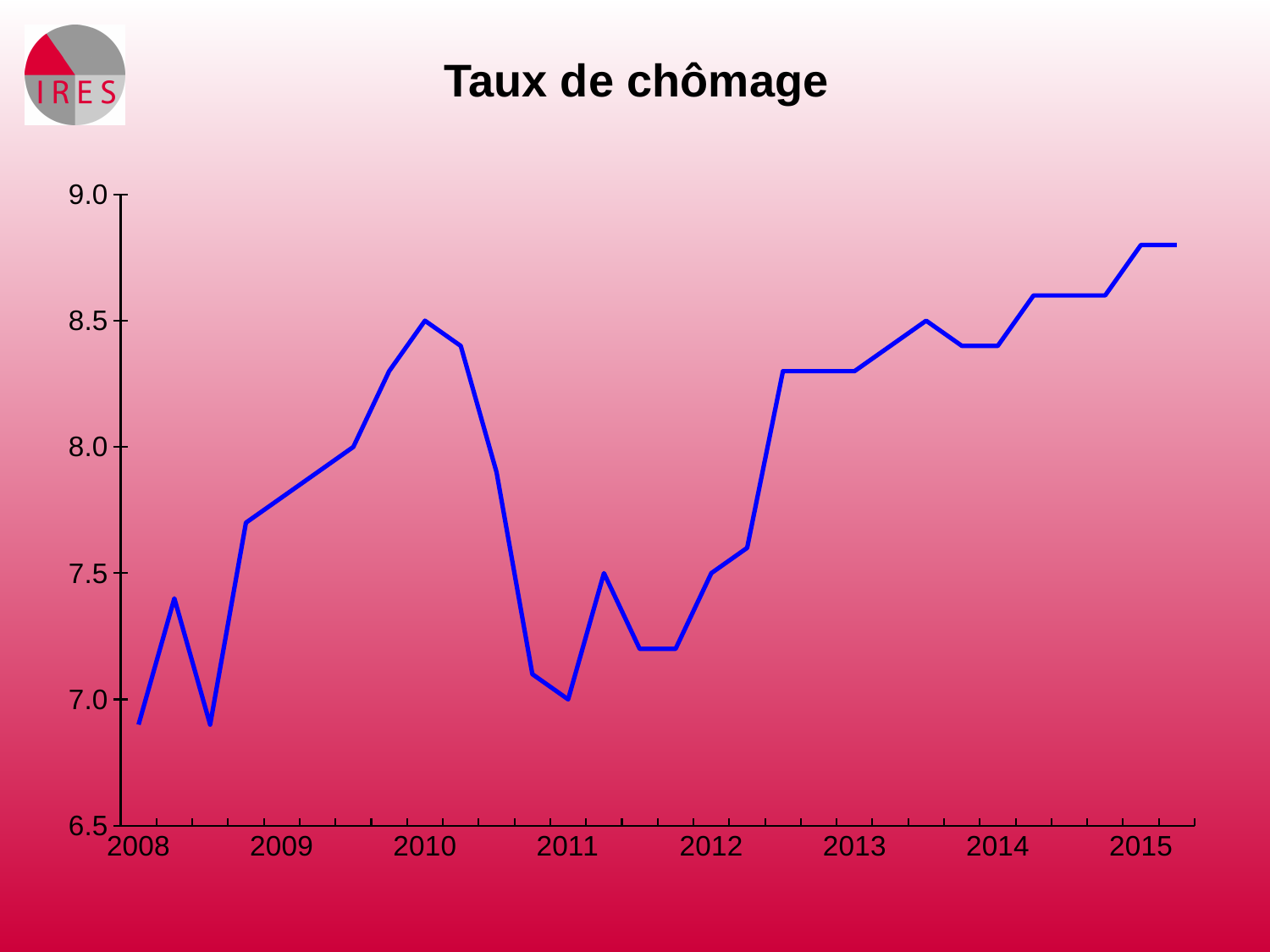
What is the value of the line at 2010? 8.5 What kind of chart is shown on the slide? line chart Is the value at 2015 greater or less than 8.5? greater Is the value at 2008 greater or less than 7.0? less How many year labels are shown on the x axis? 8 What is the value of the line at 2011? 7.0 Is the value at 2013 greater or less than 8.0? greater What is the difference between the value at 2010 and the value at 2011? 1.5 What is the title of the chart? Taux de chômage Which is higher, the value at 2010 or the value at 2011? 2010 What is the value of the line at 2012? 7.5 Does the line rise or fall from 2012 to 2015? rise